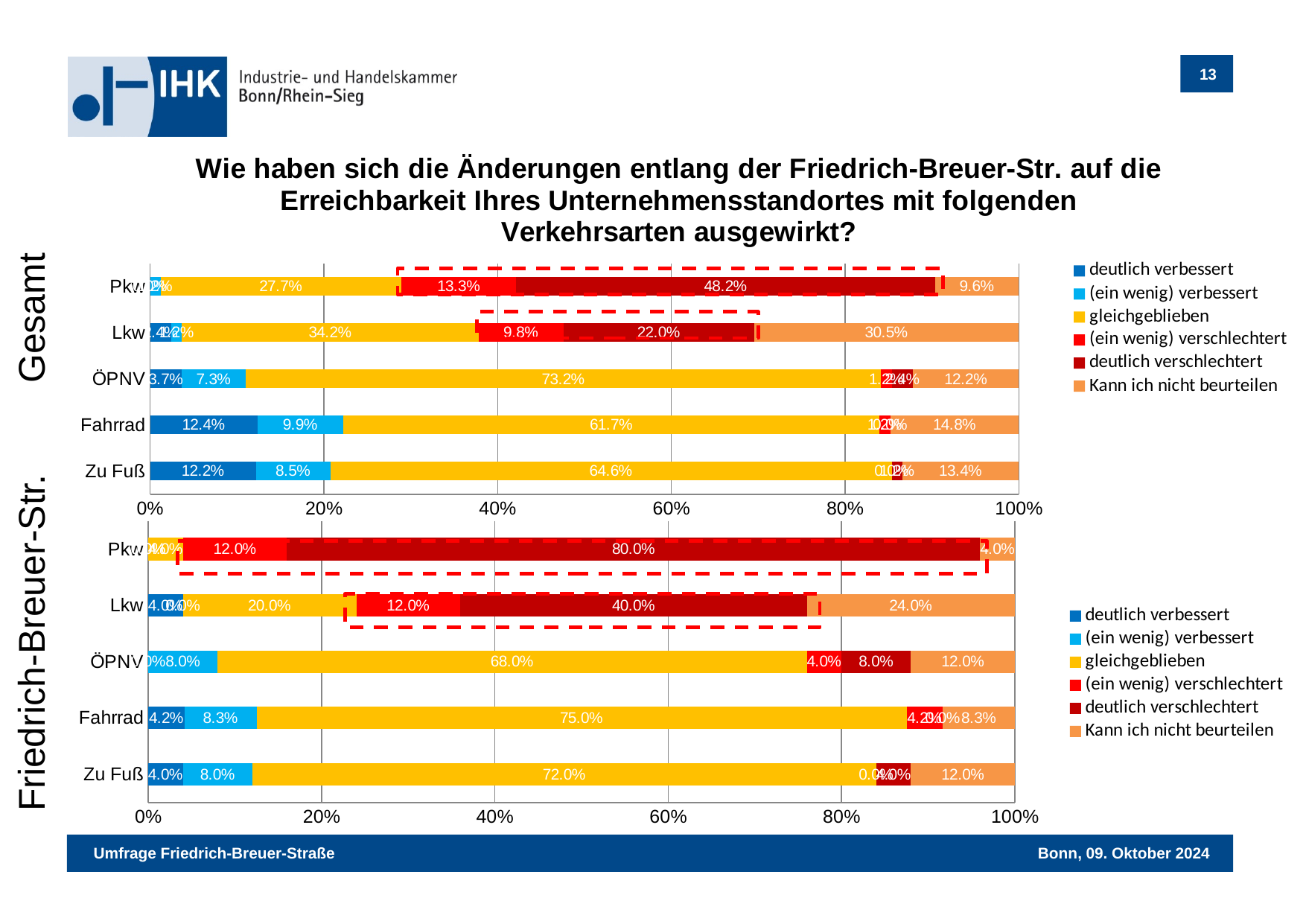
In the bottom chart (Friedrich-Breuer-Str.), which is larger: "deutlich verschlechtert" for Lkw or for ÖPNV? Lkw In the top chart (Gesamt), what is the difference between the "gleichgeblieben" values for Zu Fuß and Fahrrad? 2.9% How many categories are shown on the y axis of the top chart (Gesamt)? 5 How many series does the legend of the bottom chart (Friedrich-Breuer-Str.) list? 6 In the bottom chart (Friedrich-Breuer-Str.), what is the value of "deutlich verschlechtert" for Pkw? 80.0% In the top chart (Gesamt), what is the value of "deutlich verschlechtert" for Pkw? 48.2% In the top chart (Gesamt), which category has the highest "deutlich verbessert" value? Fahrrad In the top chart (Gesamt), what is the value of "gleichgeblieben" for ÖPNV? 73.2% In the bottom chart (Friedrich-Breuer-Str.), what is the value of "Kann ich nicht beurteilen" for Lkw? 24.0% In the bottom chart (Friedrich-Breuer-Str.), what is the value of "gleichgeblieben" for Fahrrad? 75.0% What kind of chart is the top chart (Gesamt)? Stacked bar chart In the top chart (Gesamt), what is the value of "Kann ich nicht beurteilen" for Lkw? 30.5%